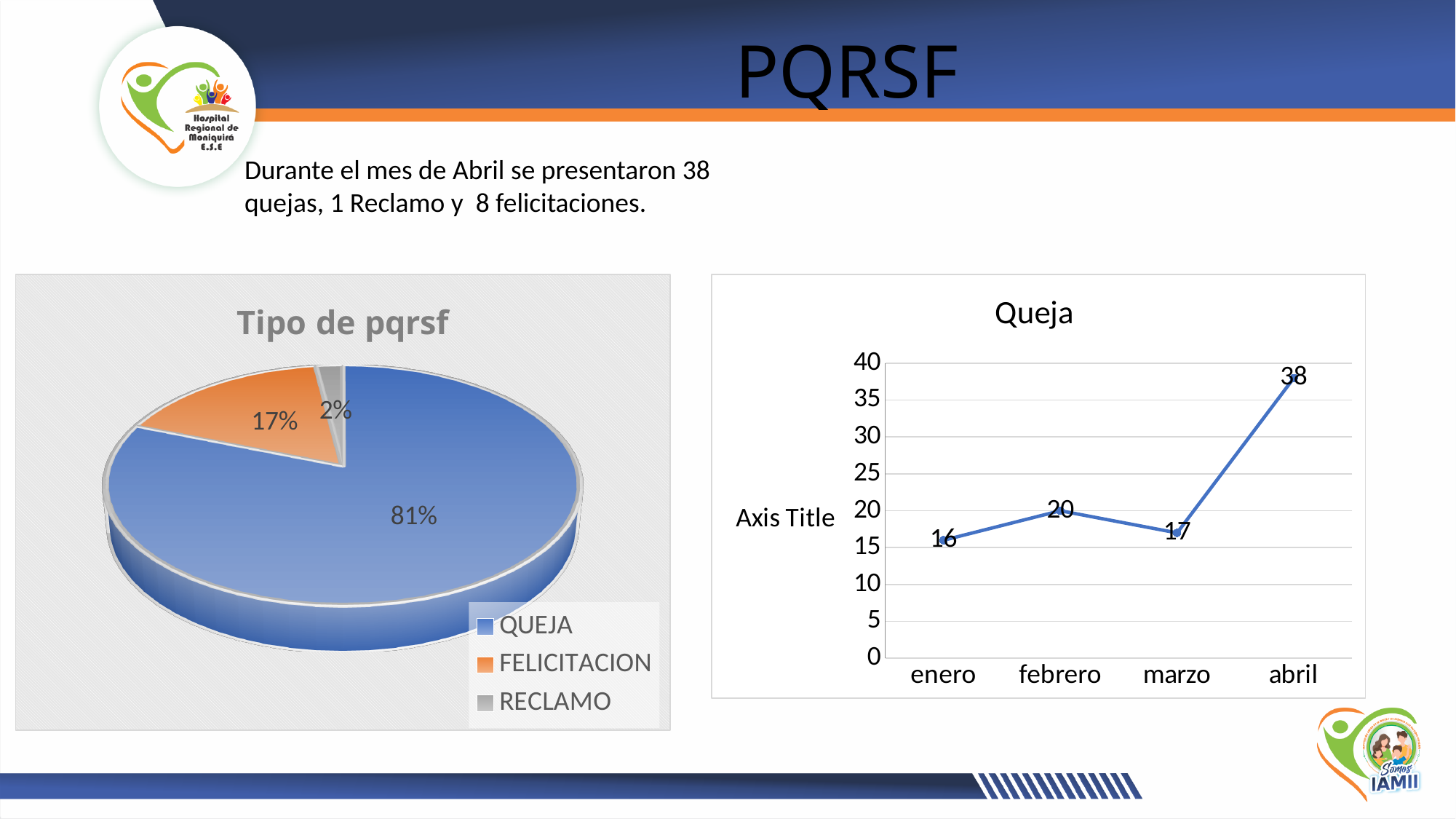
What kind of chart is the 'Queja' chart? Line chart In the 'Queja' chart, what is the value for febrero? 20 In the 'Tipo de pqrsf' pie chart, which category has the largest slice? QUEJA In the 'Queja' chart, which month has the lowest value? enero In the 'Tipo de pqrsf' pie chart, which category has the smallest slice? RECLAMO In the 'Queja' chart, what is the value for abril? 38 In the 'Queja' chart, what is the difference between the values for abril and marzo? 21 In the 'Tipo de pqrsf' pie chart, what share does FELICITACION have? 17% In the 'Tipo de pqrsf' pie chart, what share does QUEJA have? 81% What kind of chart is the 'Tipo de pqrsf' chart? Pie chart In the 'Tipo de pqrsf' pie chart, what share does RECLAMO have? 2% How many categories does the legend of the 'Tipo de pqrsf' chart list? 3